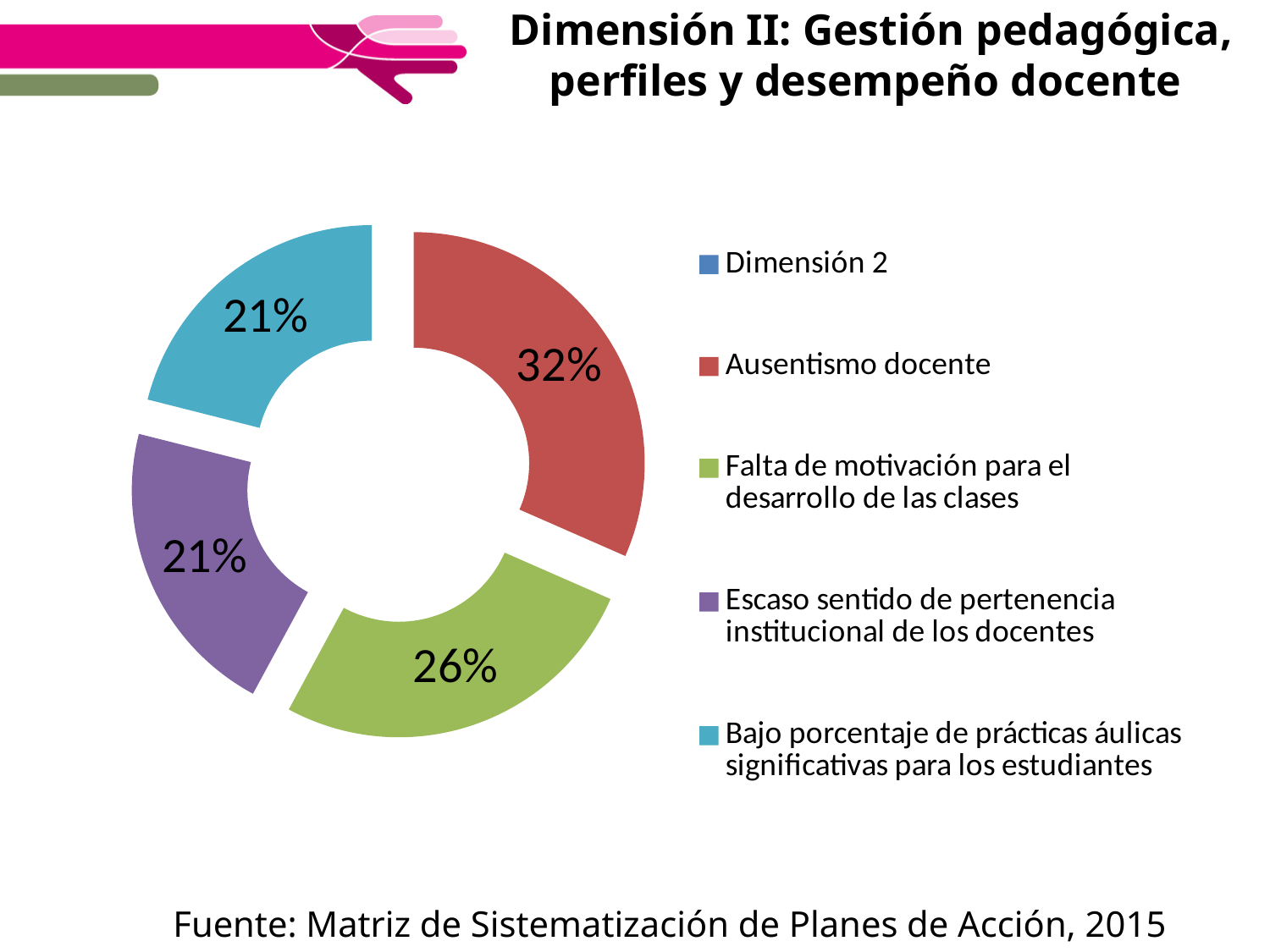
What percentage is shown for "Bajo porcentaje de prácticas áulicas significativas para los estudiantes"? 21% Which is larger: the share for "Falta de motivación para el desarrollo de las clases" or the share for "Escaso sentido de pertenencia institucional de los docentes"? Falta de motivación para el desarrollo de las clases What percentage is shown for "Escaso sentido de pertenencia institucional de los docentes"? 21% What percentage is shown for "Ausentismo docente"? 32% What percentage is shown for "Falta de motivación para el desarrollo de las clases"? 26% What is the difference in percentage points between "Ausentismo docente" and "Falta de motivación para el desarrollo de las clases"? 6 percentage points How many slices with data labels does the chart show? 4 Which two categories share the smallest percentage on the chart? Escaso sentido de pertenencia institucional de los docentes and Bajo porcentaje de prácticas áulicas significativas para los estudiantes How many entries does the legend list? 5 What kind of chart is shown on the slide? Doughnut (pie) chart Which category has the largest share of the chart? Ausentismo docente What colour is the slice for "Ausentismo docente"? Red